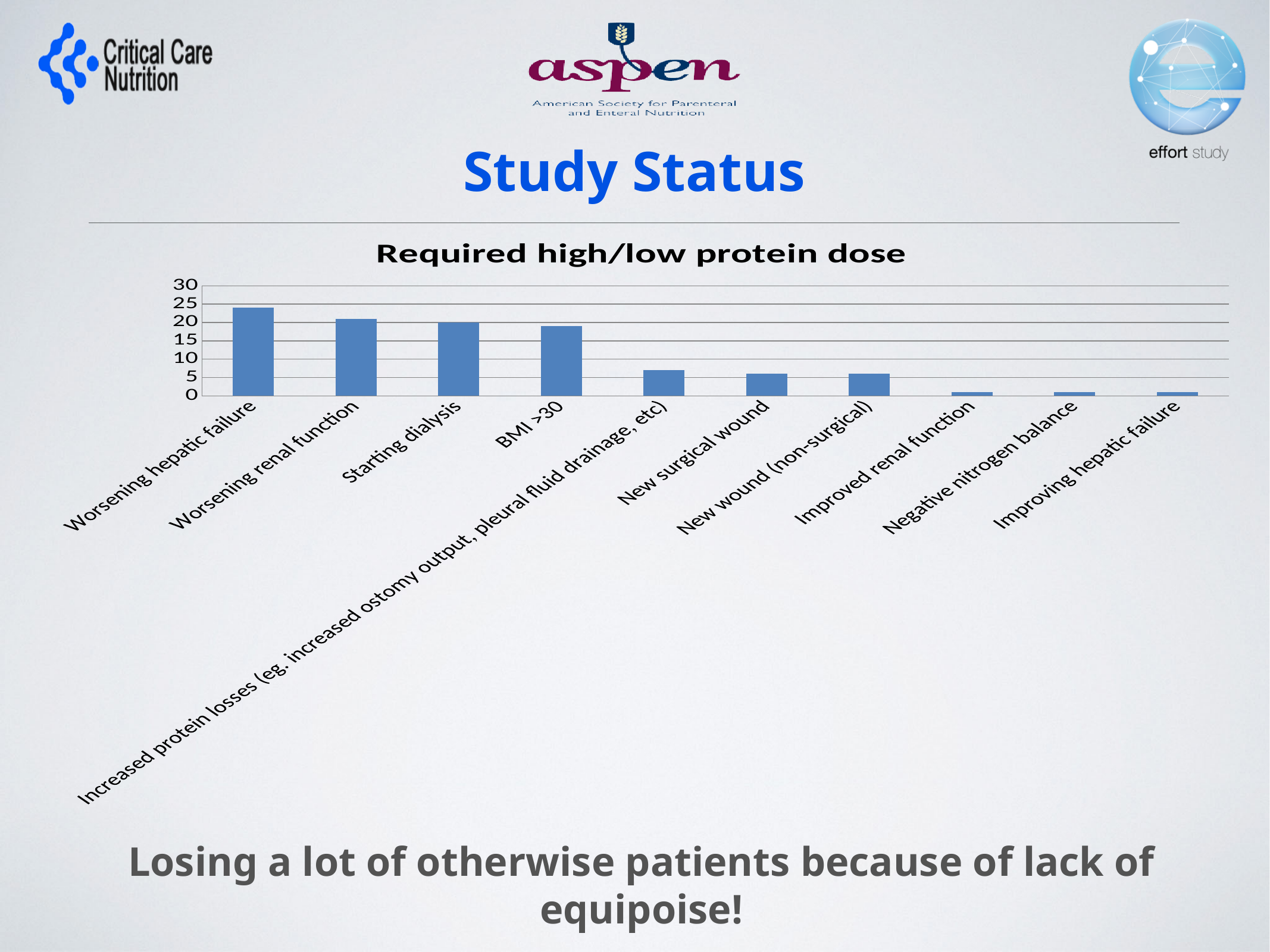
Which category has the highest value in the "Required high/low protein dose" chart? Worsening hepatic failure Is the value for Worsening hepatic failure greater or less than 20? greater Is the value for Increased protein losses (eg. increased ostomy output, pleural fluid drainage, etc) greater or less than 10? less Is the value for BMI >30 greater or less than 15? greater What is the title of the chart on the slide? Required high/low protein dose Do the bar values generally rise or fall moving from left to right along the x axis? fall Which is larger, the value for Worsening hepatic failure or the value for New surgical wound? Worsening hepatic failure What kind of chart is shown under the title "Required high/low protein dose"? bar chart How many categories are plotted in the "Required high/low protein dose" chart? 10